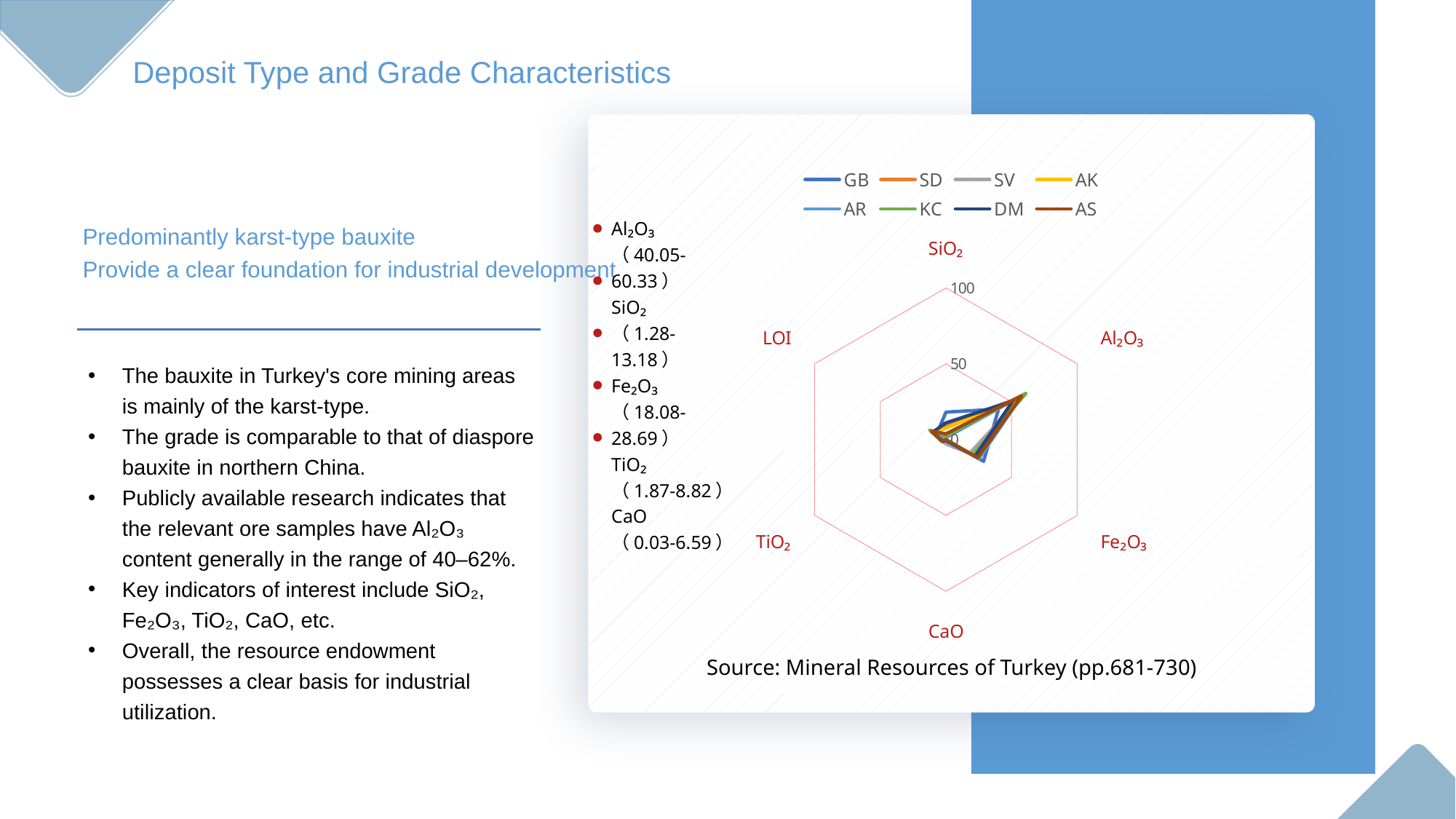
Which category axis do the plotted lines extend furthest along? Al₂O₃ How many axes (categories) does the radar chart have? 6 What source is cited below the chart? Mineral Resources of Turkey (pp.681-730) Is the value for CaO for series AS greater or less than 50? less Is the value for LOI for series DM greater or less than 50? less How many series does the chart legend list? 8 What kind of chart is shown on the slide? Radar chart Is the value for SiO₂ for series SD greater or less than 50? less What is the maximum value shown on the radar chart's axis scale? 100